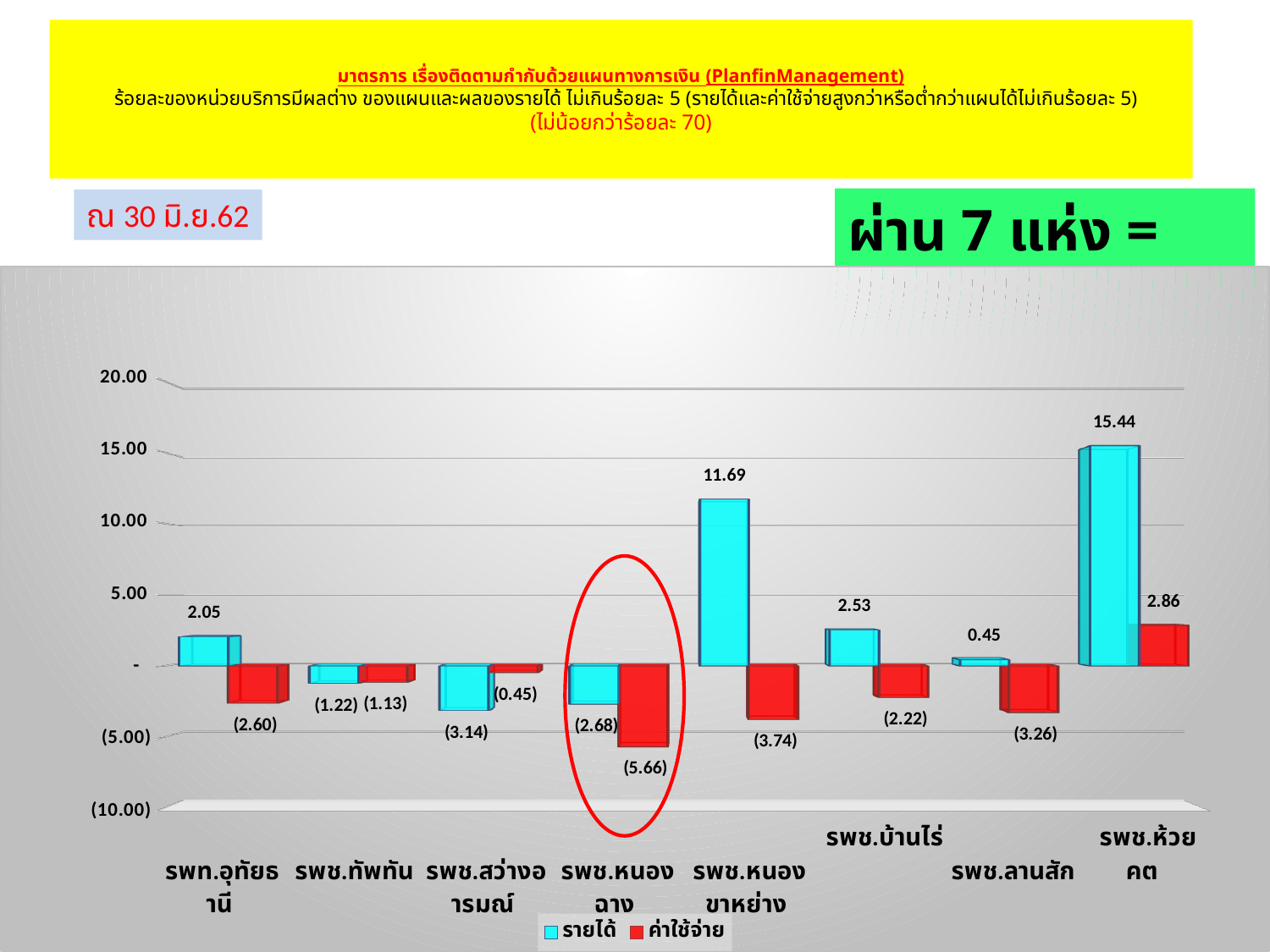
What kind of chart is shown on the slide? bar chart How many categories are shown on the x axis? 8 What is the ค่าใช้จ่าย value for รพช.หนองฉาง? (5.66) Which is larger, the รายได้ value for รพท.อุทัยธานี or for รพช.บ้านไร่? รพช.บ้านไร่ Which category has the highest รายได้ value? รพช.ห้วยคต How many series does the legend list? 2 What is the difference between the รายได้ values of รพช.ห้วยคต and รพช.หนองขาหย่าง? 3.75 What is the รายได้ value for รพช.ห้วยคต? 15.44 What is the รายได้ value for รพช.หนองขาหย่าง? 11.69 Is the รายได้ value for รพช.หนองขาหย่าง greater or less than 10.00? greater What is the ค่าใช้จ่าย value for รพช.ลานสัก? (3.26) Which category has the lowest ค่าใช้จ่าย value? รพช.หนองฉาง